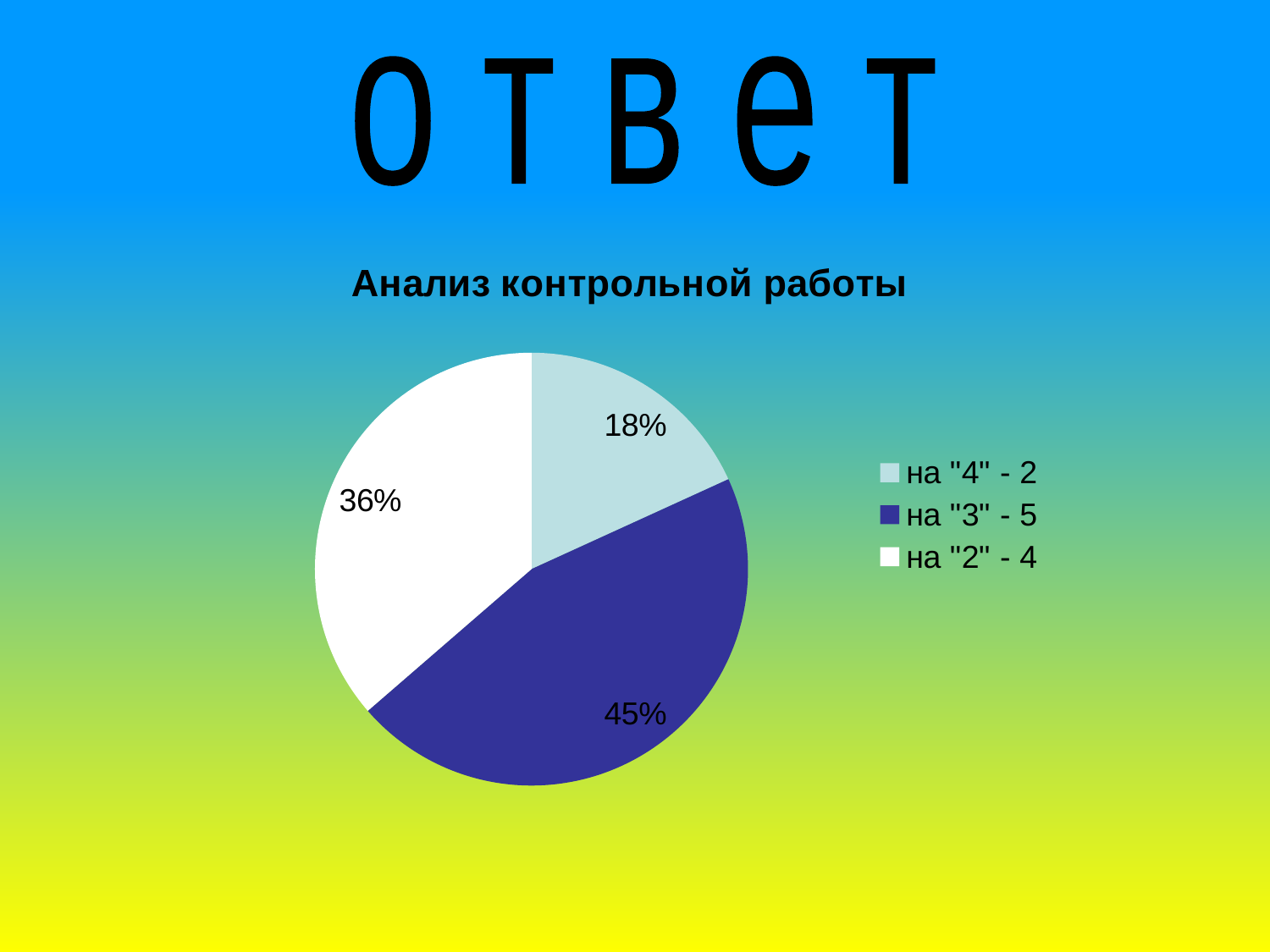
Which slice is larger: на "2" - 4 or на "4" - 2? на "2" - 4 What kind of chart is shown on the slide? pie chart What share of the pie does the slice for на "2" - 4 take? 36% How many slices does the pie chart have? 3 What is the difference in percentage points between the slices for на "3" - 5 and на "2" - 4? 9% What share of the pie does the slice for на "4" - 2 take? 18% What is the title of the chart? Анализ контрольной работы Which category has the smallest slice of the pie? на "4" - 2 What share of the pie does the slice for на "3" - 5 take? 45% Which category has the largest slice of the pie? на "3" - 5 What colour is the slice for на "3" - 5? dark blue What is the difference in percentage points between the slices for на "3" - 5 and на "4" - 2? 27%